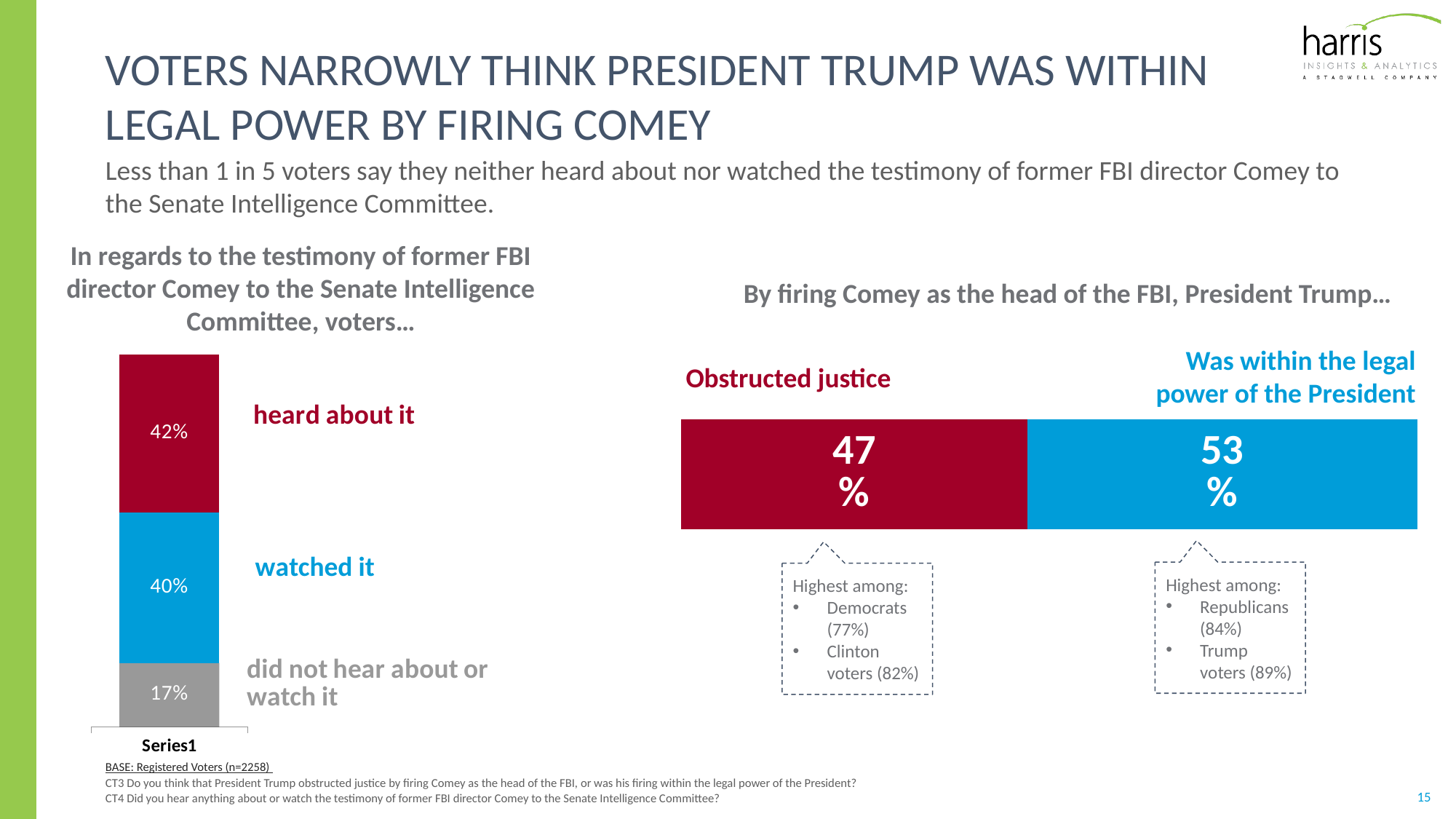
In the right chart 'By firing Comey as the head of the FBI, President Trump...', what percentage say he was within the legal power of the President? 53% In the right chart 'By firing Comey as the head of the FBI, President Trump...', what is the difference between the two responses? 6% In the left chart about the Comey testimony, what percentage of voters did not hear about or watch it? 17% In the right chart, what colour is the 'Obstructed justice' segment? Red What type of chart is the right chart 'By firing Comey as the head of the FBI, President Trump...'? Stacked bar chart In the right chart 'By firing Comey as the head of the FBI, President Trump...', what percentage say he obstructed justice? 47% In the left chart about the Comey testimony, how many segments make up the stacked bar? 3 In the left chart about the Comey testimony, which response has the smallest share? did not hear about or watch it In the left chart about the Comey testimony, what percentage of voters watched it? 40% In the left chart about the Comey testimony, what is the difference between the share who heard about it and the share who did not hear about or watch it? 25% In the left chart about the Comey testimony, what percentage of voters heard about it? 42% In the right chart 'By firing Comey as the head of the FBI, President Trump...', which response is larger: obstructed justice or was within the legal power of the President? Was within the legal power of the President